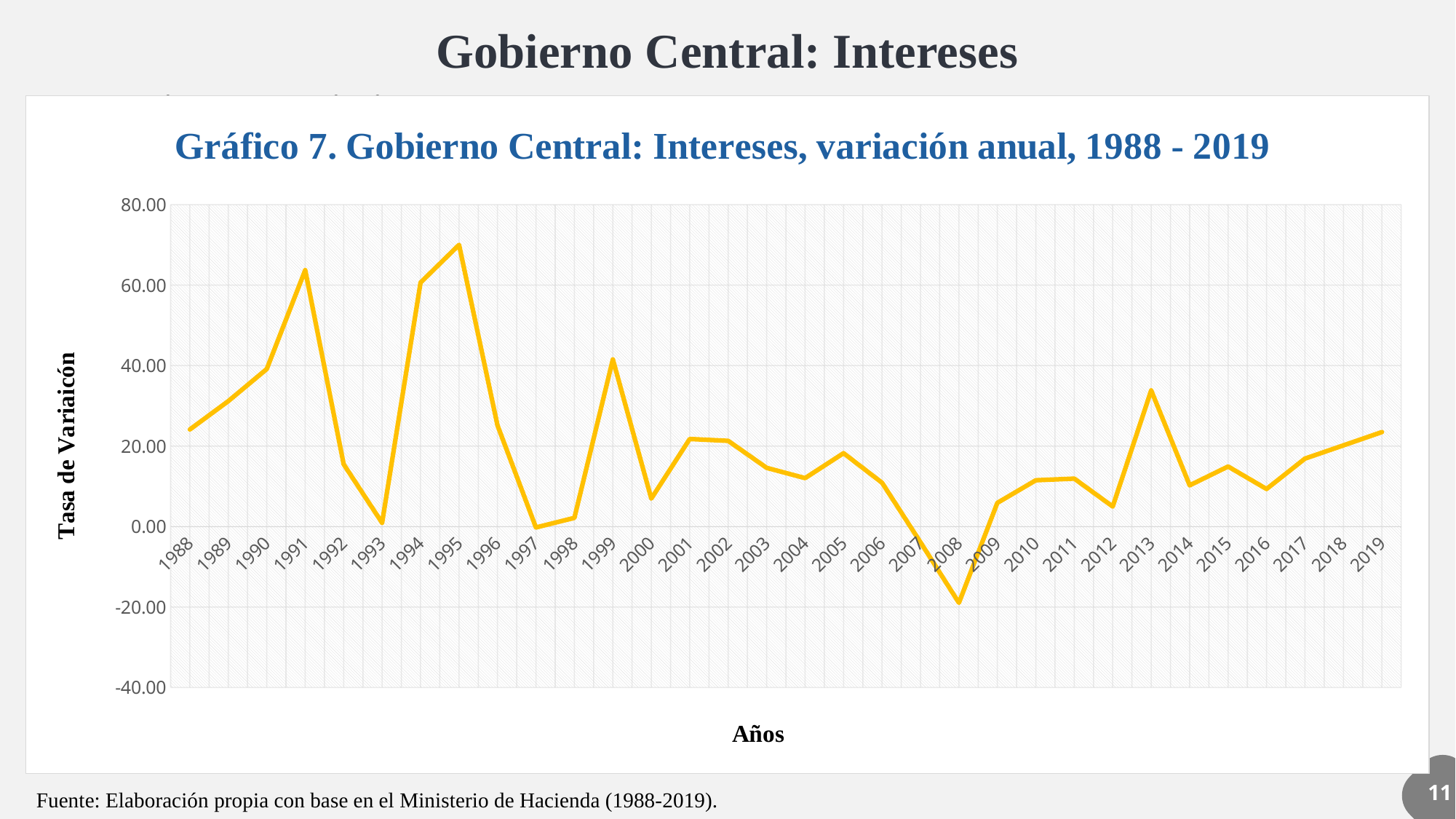
How many years are plotted along the x axis of the chart? 32 In which year does the line reach its lowest value? 2008 Is the value for 2013 greater or less than 20.00? greater Is the value for 1991 greater or less than 60.00? greater Does the line rise or fall from 1988 to 1991? rise What kind of chart is shown on the slide? line chart Is the value for 2008 greater or less than 0.00? less What is the label of the y axis of the chart? Tasa de Variaicón In which year does the line reach its highest value? 1995 Which year has the larger value, 1999 or 2005? 1999 Does the line rise or fall from 2016 to 2019? rise